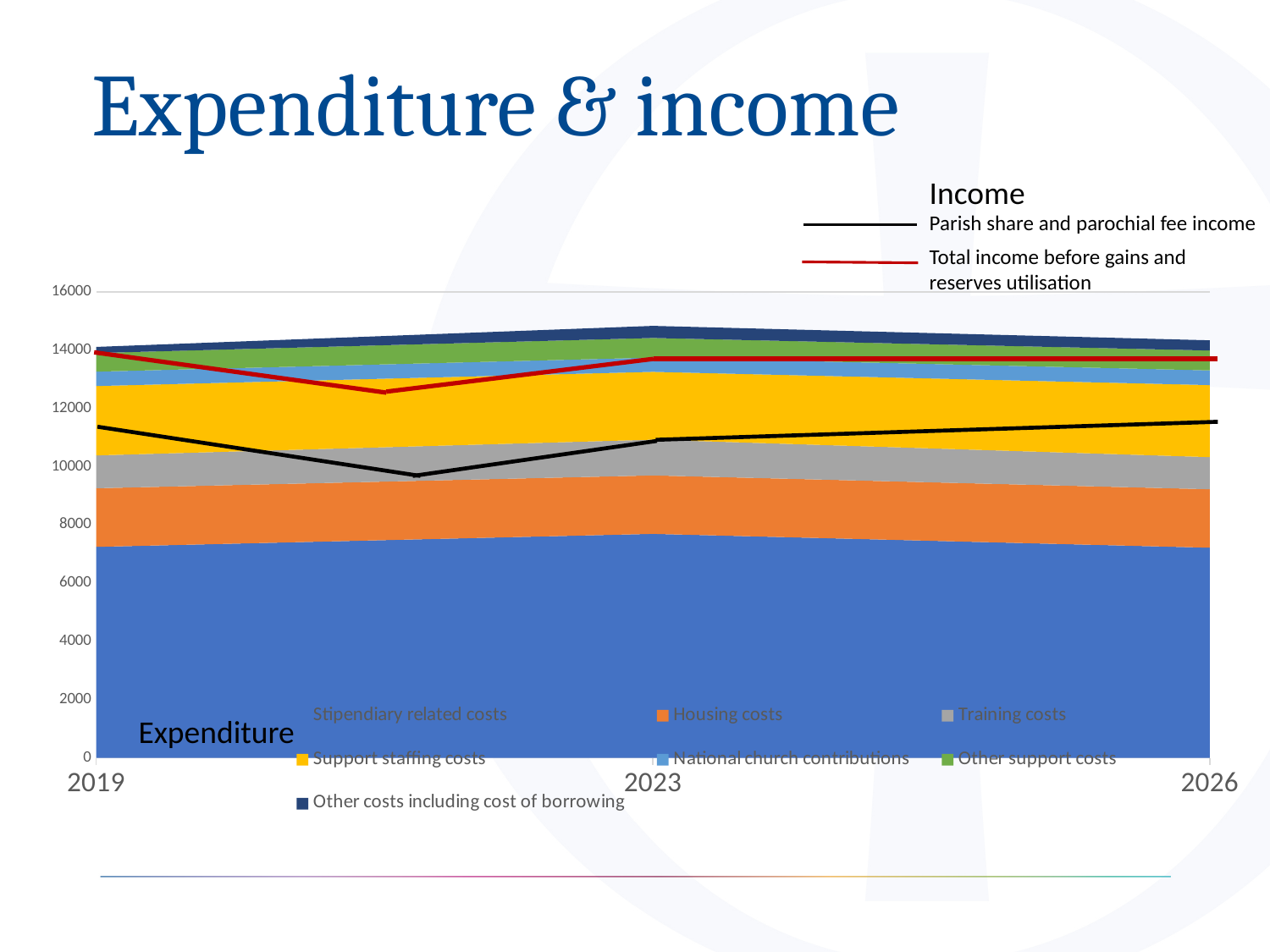
What colour is the line for Total income before gains and reserves utilisation? red What kind of chart is used to show the expenditure categories on this slide? area chart Is the value of Stipendiary related costs in 2019 greater or less than 6000? greater Which expenditure category forms the largest band of the stacked area? Stipendiary related costs Is the value of Parish share and parochial fee income in 2019 greater or less than 10000? greater Is the value of Parish share and parochial fee income in 2019 greater or less than 12000? less How many expenditure series does the Expenditure legend list? 7 How many series does the Income legend list? 2 In 2023, which is larger: Parish share and parochial fee income or Total income before gains and reserves utilisation? Total income before gains and reserves utilisation Does Parish share and parochial fee income rise or fall between 2023 and 2026? rise